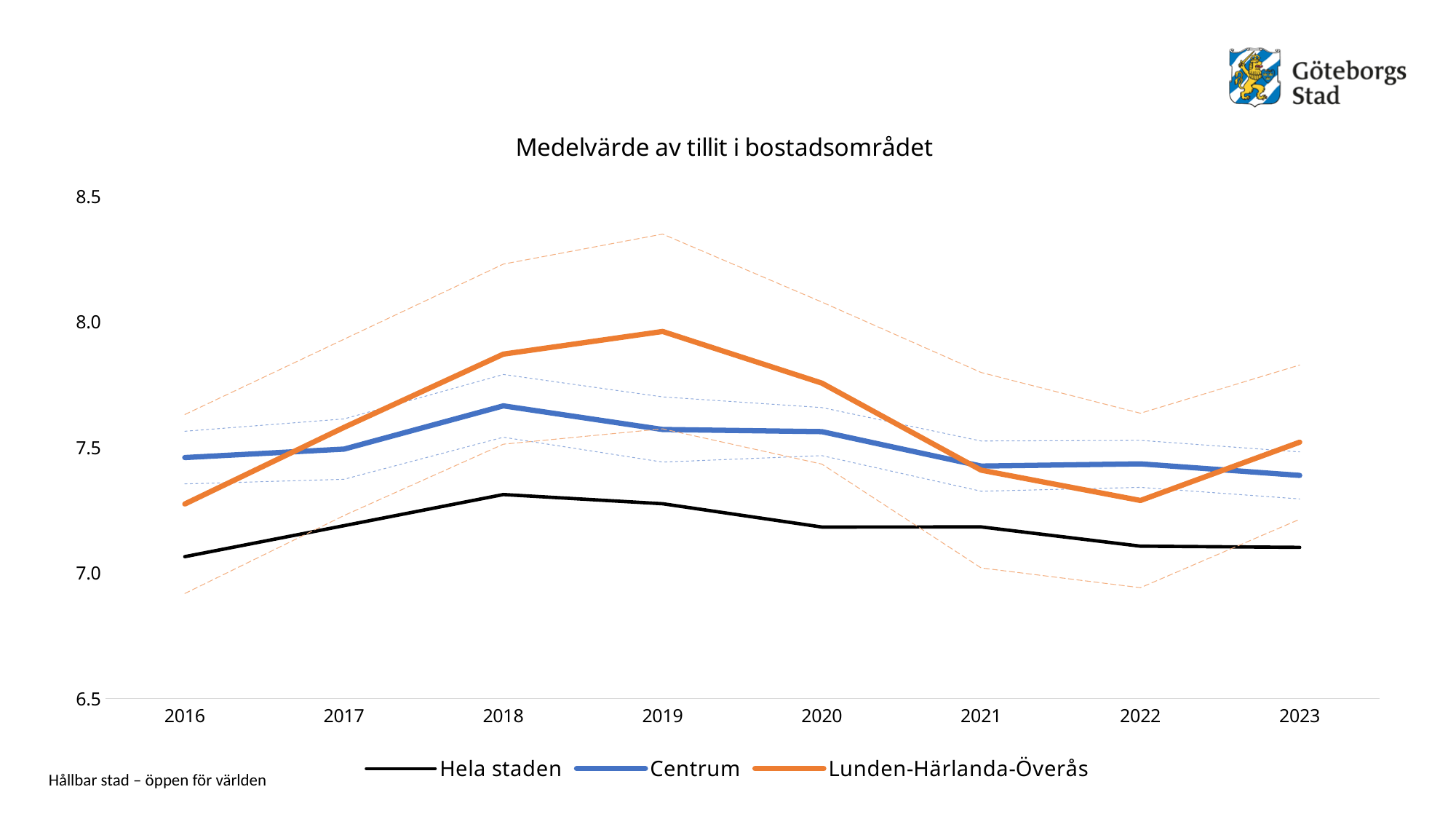
Is the value for Hela staden in 2018 greater or less than 7.5? less In which year does the Lunden-Härlanda-Överås line reach its highest value? 2019 Is the value for Lunden-Härlanda-Överås in 2019 greater or less than 7.5? greater In which year does the Centrum line reach its highest value? 2018 How many years are shown on the x axis? 8 In 2022, which series has the higher value, Centrum or Lunden-Härlanda-Överås? Centrum Is the value for Lunden-Härlanda-Överås in 2016 greater or less than 7.5? less In which year does the Hela staden line reach its highest value? 2018 What kind of chart is shown on the slide? Line chart How many series does the legend list? 3 What is the title of the chart? Medelvärde av tillit i bostadsområdet Does the Hela staden line rise or fall from 2018 to 2023? Fall